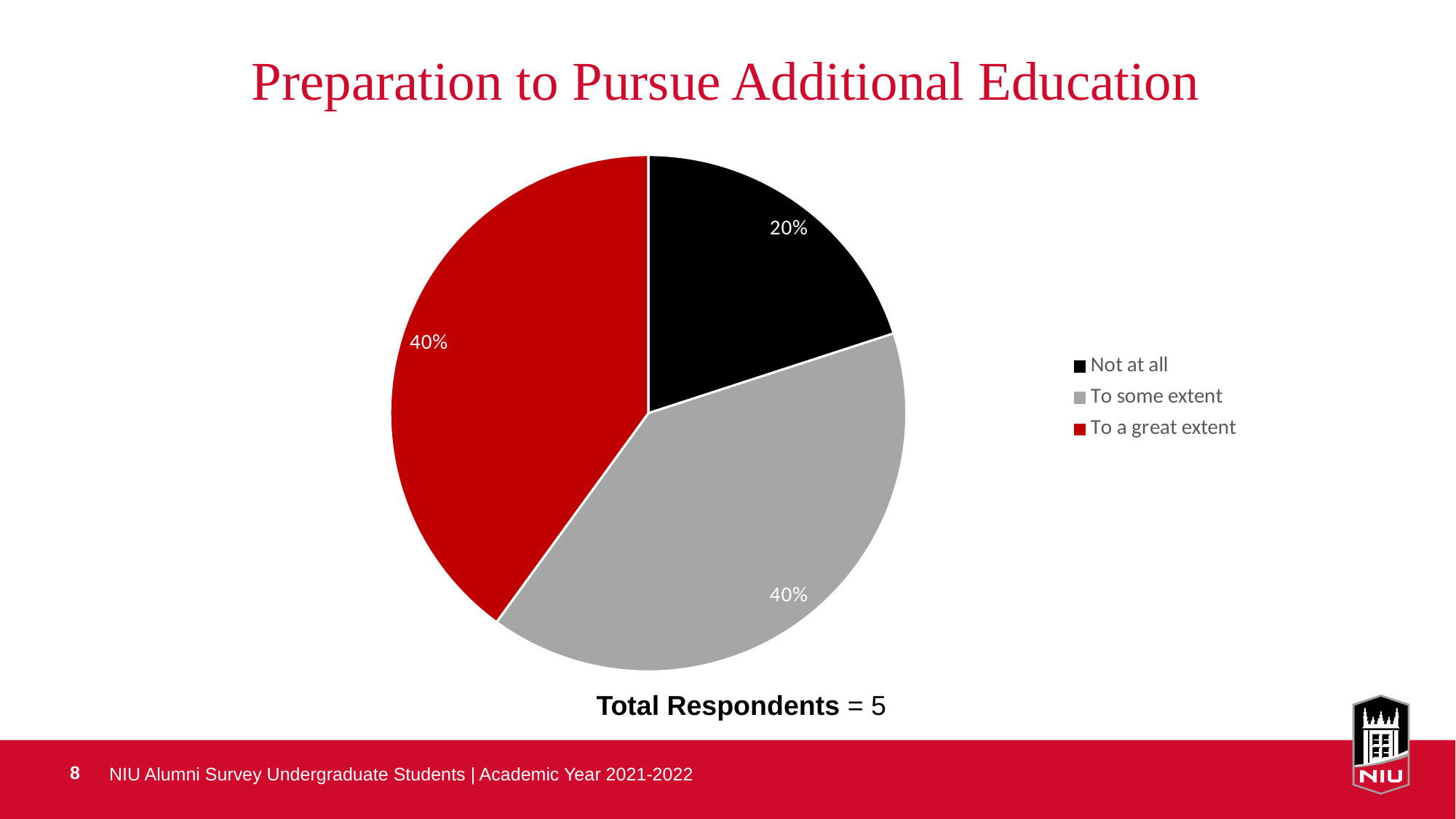
What share of the pie is 'To some extent'? 40% Which category has the smallest slice of the pie? Not at all What is the combined share of 'To some extent' and 'To a great extent'? 80% How many categories does the legend list? 3 What colour is the slice for 'To a great extent'? Red What is the title of the slide containing the chart? Preparation to Pursue Additional Education What kind of chart is shown on the slide? Pie chart What share of the pie is 'Not at all'? 20% Which is larger, the slice for 'Not at all' or the slice for 'To a great extent'? To a great extent What share of the pie is 'To a great extent'? 40% What is the difference in percentage points between 'To some extent' and 'Not at all'? 20% How many total respondents are reported below the chart? 5